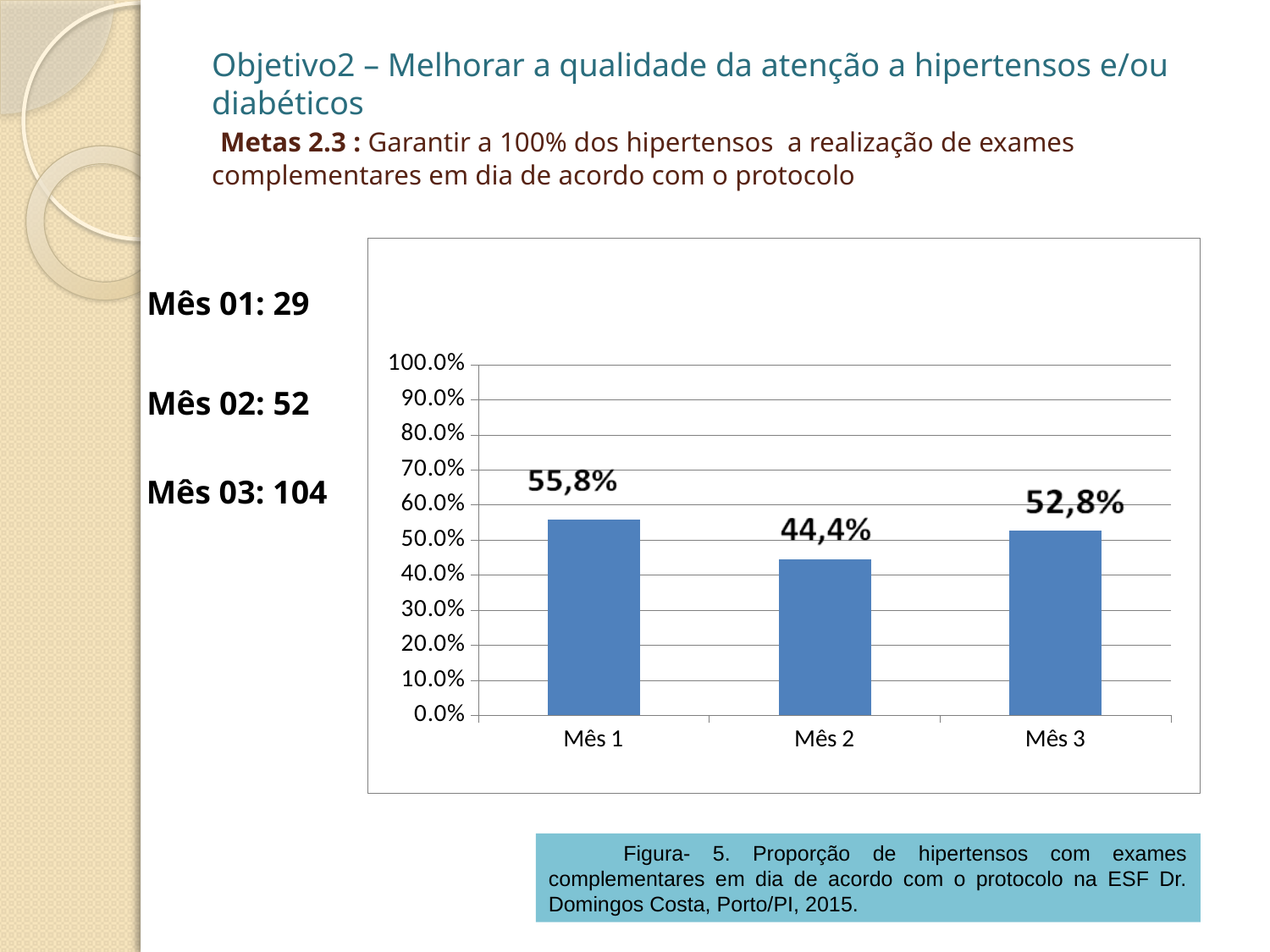
Which is larger, the value for Mês 1 or Mês 3? Mês 1 What kind of chart is shown? bar chart What is the value for Mês 1? 55,8% Which month has the highest value? Mês 1 How many months are shown on the x axis? 3 What is the value for Mês 3? 52,8% What is the value for Mês 2? 44,4% What is the difference between the values for Mês 3 and Mês 2? 8,4% Which month has the lowest value? Mês 2 Is the value for Mês 2 greater or less than 50.0%? less What is the difference between the values for Mês 1 and Mês 2? 11,4% What is the highest tick value on the y axis? 100.0%